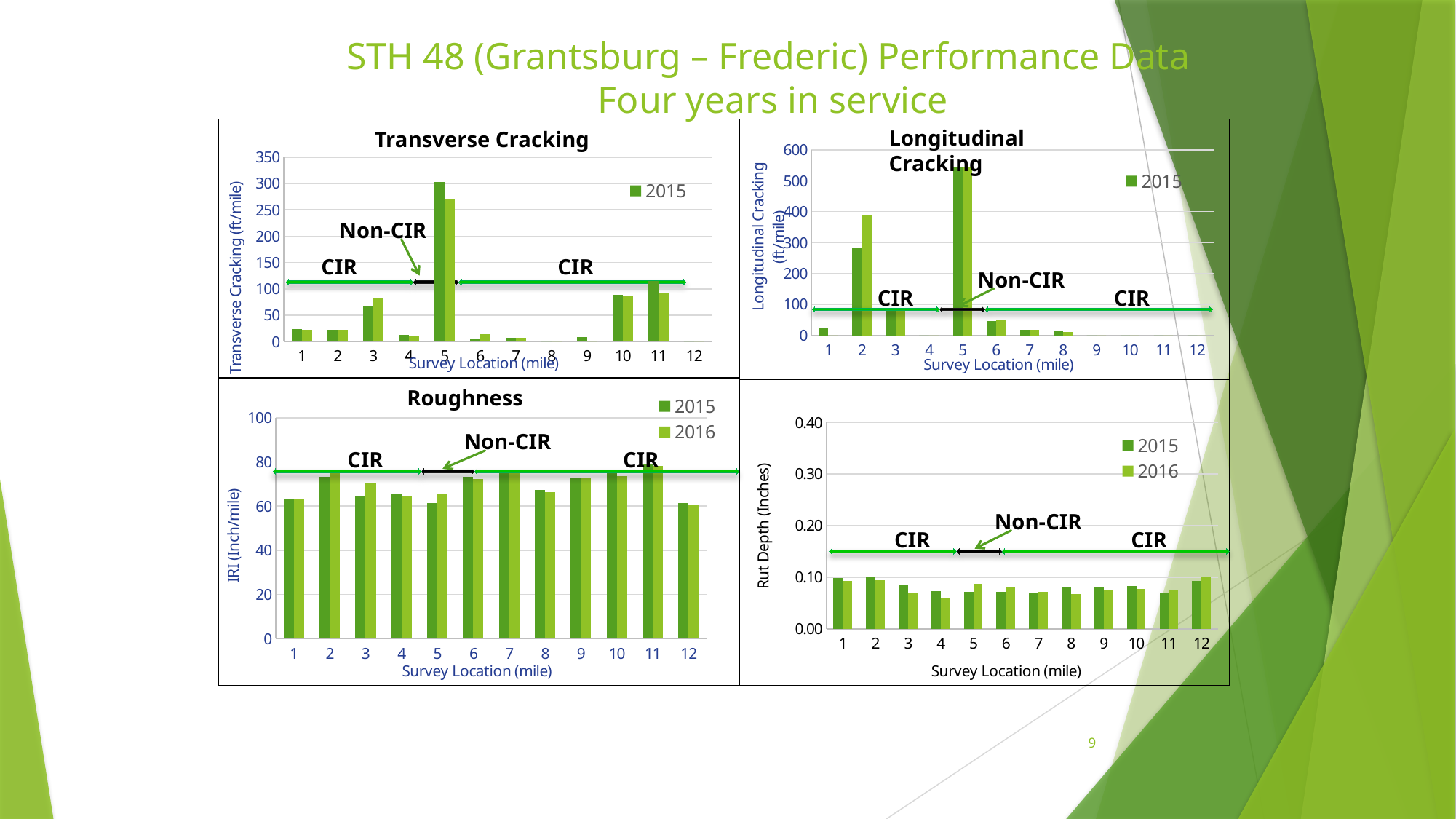
In the Transverse Cracking chart, which survey location has the highest transverse cracking value? 5 In the Transverse Cracking chart, is the 2015 value at survey location 5 greater or less than 250? greater In the Longitudinal Cracking chart, which is larger, the value at survey location 2 or at survey location 3? survey location 2 In the Roughness chart, which is larger, the 2015 value at survey location 2 or at survey location 5? survey location 2 In the Longitudinal Cracking chart, is the 2015 value at survey location 5 greater or less than 500? greater In the bottom-right Rut Depth chart, is the 2016 value at survey location 4 greater or less than 0.10? less In the Roughness chart, how many series does the legend list? 2 What is the y-axis label of the Roughness chart? IRI (Inch/mile) In the Transverse Cracking chart, which is larger, the 2015 value at survey location 5 or at survey location 11? survey location 5 In the Longitudinal Cracking chart, which survey location has the highest longitudinal cracking value? 5 How many survey locations are shown on the x axis of the Roughness chart? 12